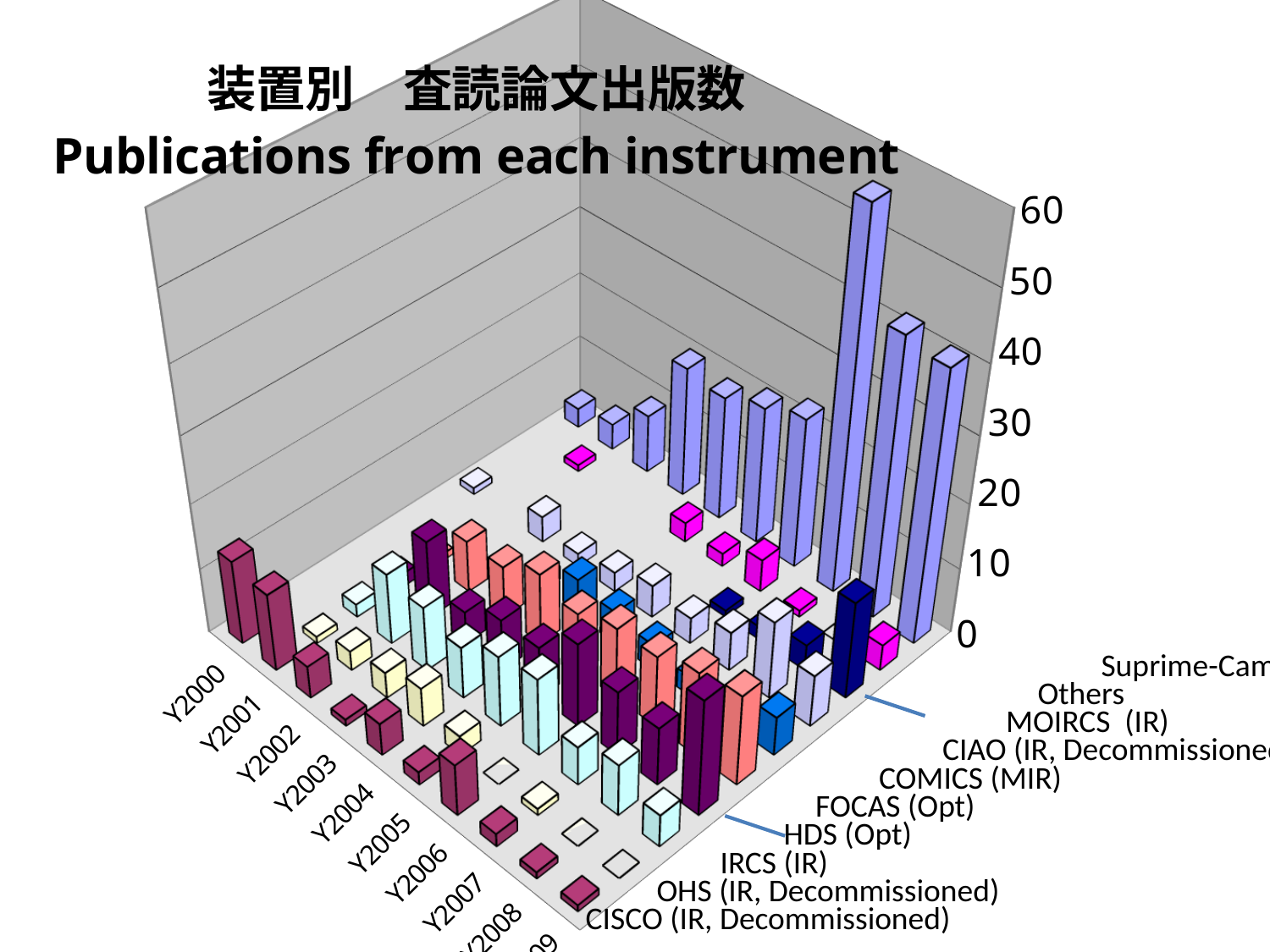
Is the tallest Suprime-Cam bar greater or less than 40? greater Do the Suprime-Cam bars generally rise or fall from Y2000 to the later years? rise What kind of chart is shown on the slide? 3D bar chart Which instrument is labelled as MIR? COMICS Which instrument has the tallest bar in the chart? Suprime-Cam What is the first year label on the horizontal axis? Y2000 How many instrument categories are labelled along the depth axis of the chart? 10 Is the tallest Suprime-Cam bar greater or less than 50? greater What is the English title of the chart? Publications from each instrument What is the maximum value shown on the vertical axis? 60